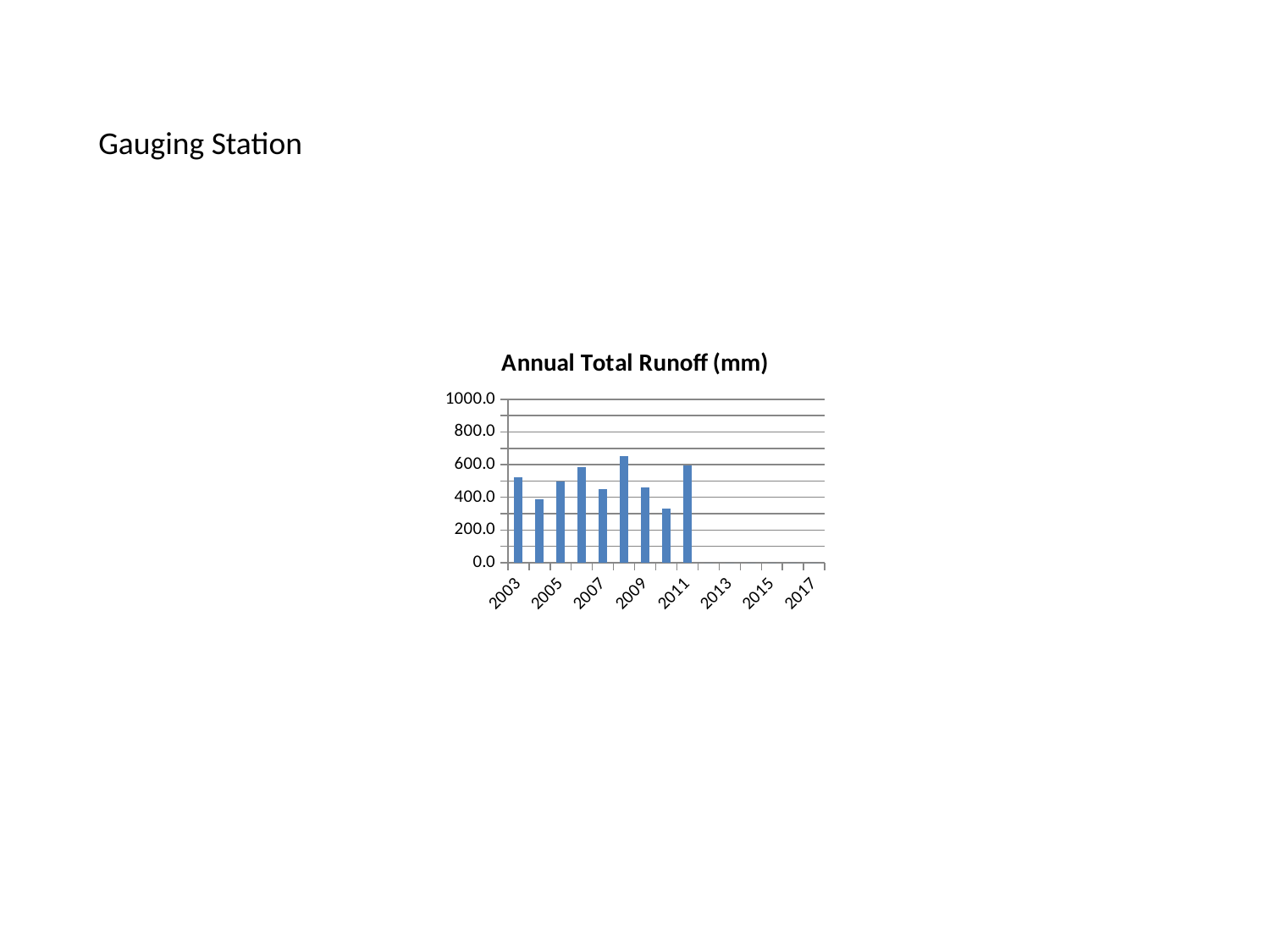
Is the value for 2003 greater or less than 400.0? greater Which year has the larger annual total runoff, 2003 or 2004? 2003 What is the highest value shown on the vertical axis? 1000.0 Which year has the highest annual total runoff? 2008 Is the value for 2010 greater or less than 400.0? less Is the value for 2008 greater or less than 600.0? greater Which year has the lowest annual total runoff? 2010 How many bars are plotted on the chart? 9 What is the title of the chart? Annual Total Runoff (mm) What kind of chart is shown on the slide? bar chart Which year has the larger annual total runoff, 2008 or 2010? 2008